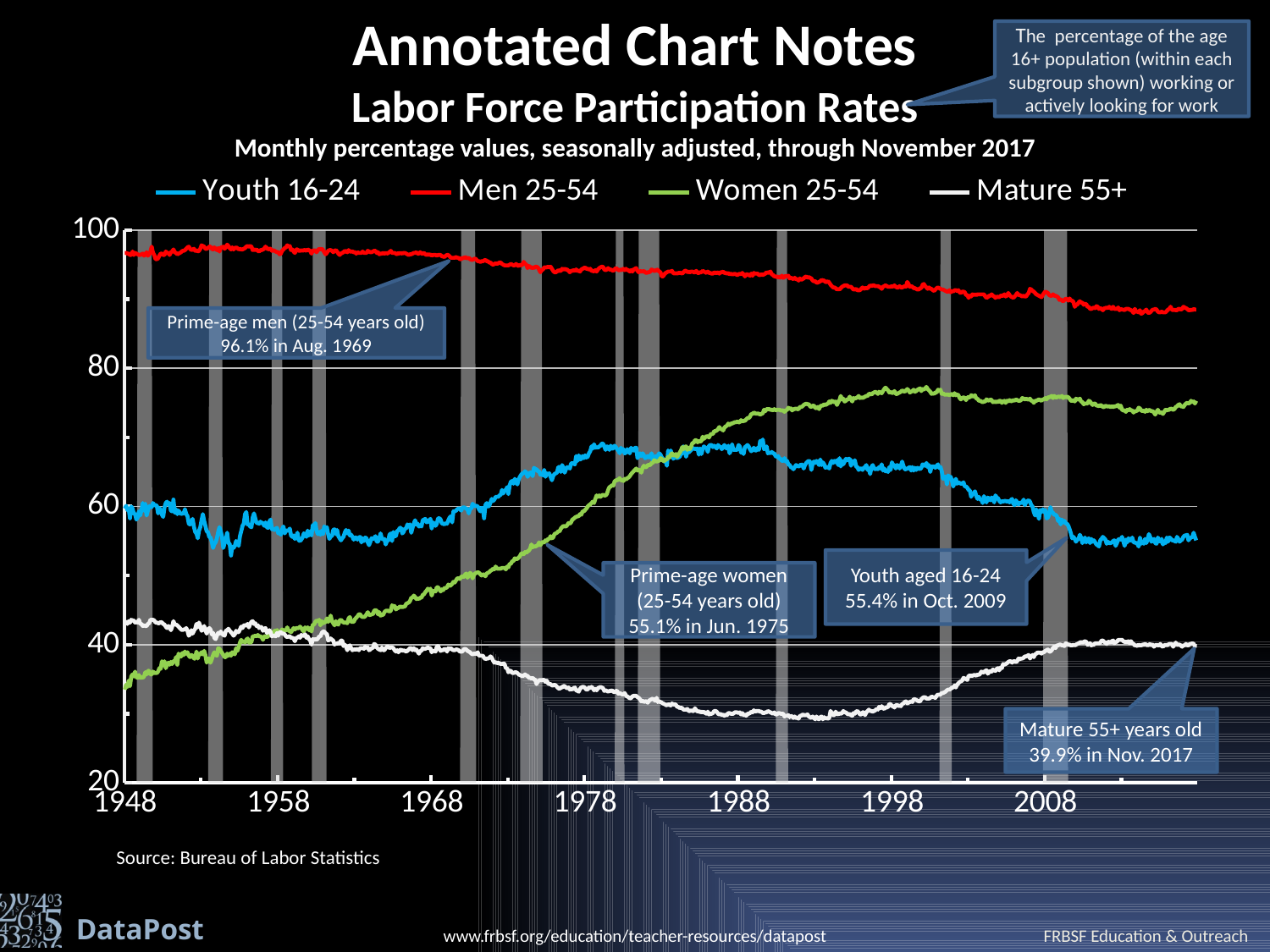
According to the annotation, what was the labor force participation rate for mature 55+ years old in Nov. 2017? 39.9% Which series has the lowest participation rate at the end of the chart (2017)? Mature 55+ Which is larger in 2017, the participation rate for Men 25-54 or for Women 25-54? Men 25-54 Which series has the highest participation rate across the whole period shown? Men 25-54 According to the annotation, what was the labor force participation rate for prime-age men (25-54) in Aug. 1969? 96.1% According to the annotation, what was the labor force participation rate for prime-age women (25-54) in Jun. 1975? 55.1% What is the source of the data cited on the slide? Bureau of Labor Statistics Does the Women 25-54 series rise or fall overall from 1948 to 2017? rise How many series does the legend list? 4 According to the annotation, what was the labor force participation rate for youth aged 16-24 in Oct. 2009? 55.4% What kind of chart is shown on the slide? line chart Is the value for Women 25-54 in 1948 greater or less than 40? less